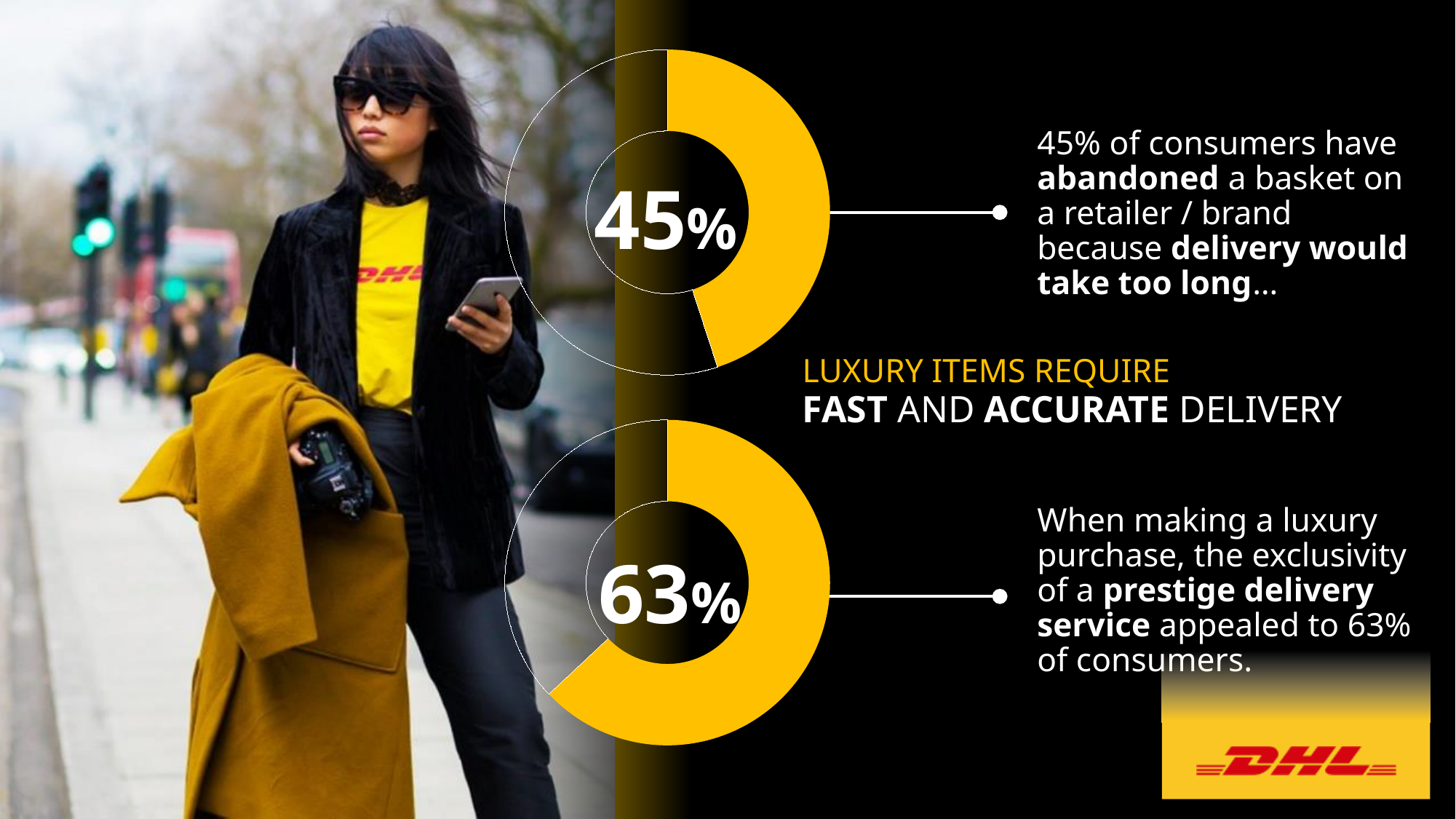
What percentage of consumers found a prestige delivery service appealing, according to the bottom donut chart? 63% Is the value shown in the top donut chart greater or less than 50%? less How many donut charts are on the slide? 2 What colour is the filled portion of the donut charts? Yellow What share of the bottom donut chart is filled in yellow? 63% What share of the top donut chart is filled in yellow? 45% Which donut chart shows the larger value, the top one or the bottom one? The bottom one (63%) What is the difference in percentage points between the bottom donut chart's value and the top donut chart's value? 18 percentage points Is the value shown in the bottom donut chart greater or less than 50%? greater What kind of chart is used to show the 45% figure? Donut (pie) chart What value is shown in the centre of the bottom donut chart? 63% What value is shown in the centre of the top donut chart? 45%